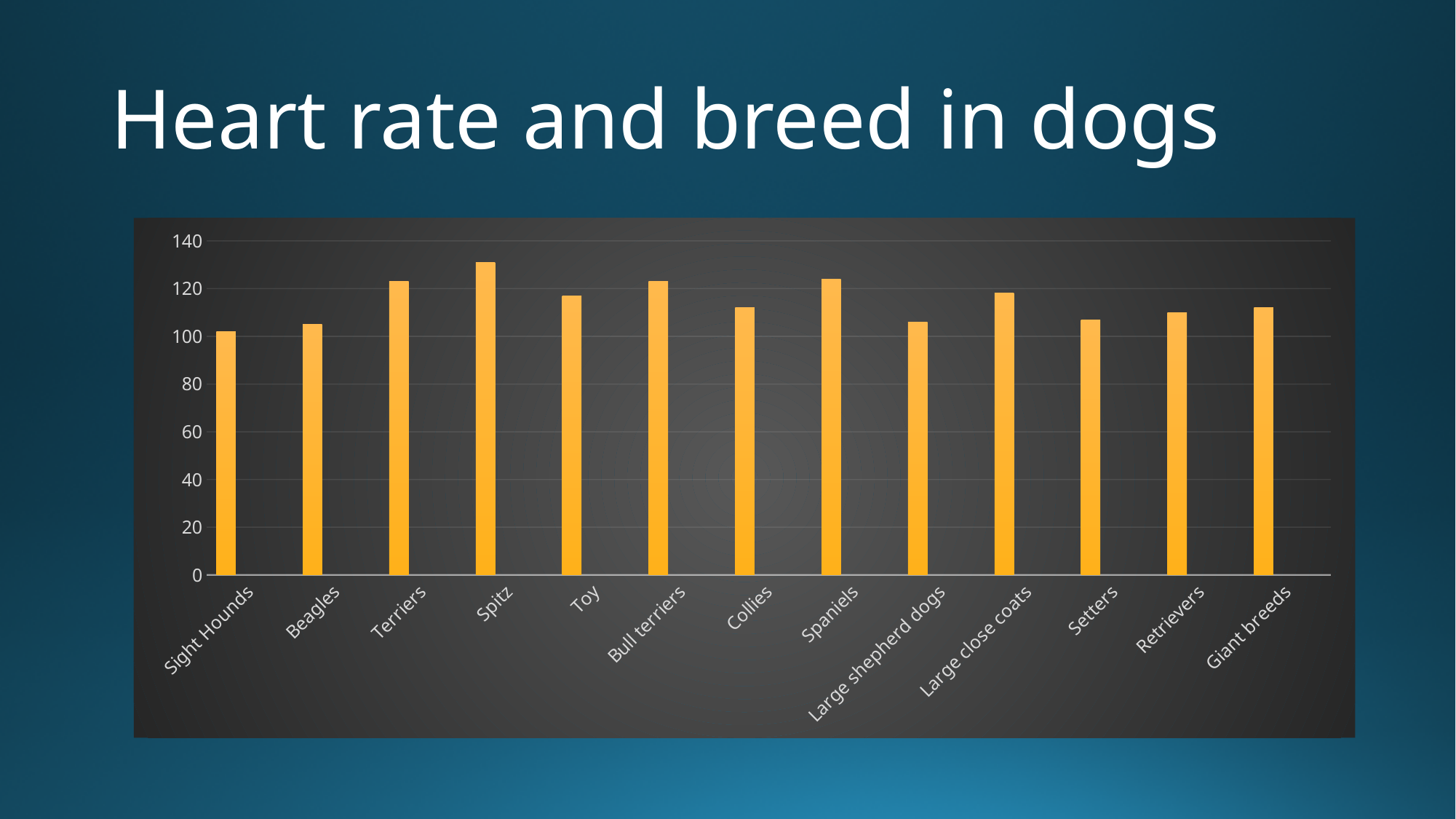
How many dog breed categories are shown on the x axis? 13 Which is larger, the value for Spaniels or the value for Large shepherd dogs? Spaniels Is the value for Spitz greater or less than 120? greater Which breed category has the highest heart rate? Spitz Is the value for Collies greater or less than 120? less Is the value for Large shepherd dogs greater or less than 120? less What is the title of the slide containing the chart? Heart rate and breed in dogs Which is larger, the value for Terriers or the value for Collies? Terriers What kind of chart is shown on the slide? bar chart Which is larger, the value for Spitz or the value for Toy? Spitz